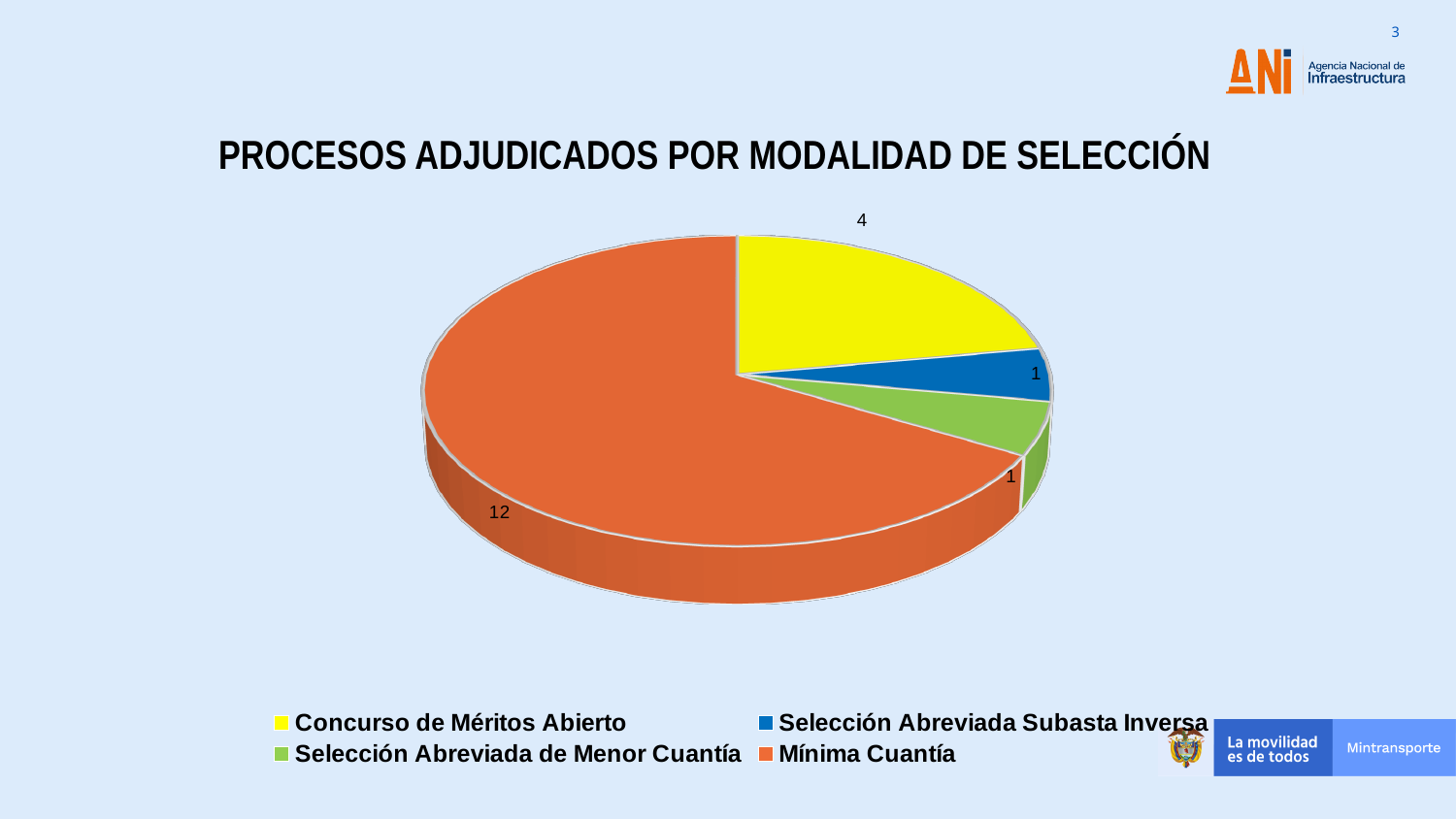
What is the value for Selección Abreviada Subasta Inversa? 1 What is the value for Mínima Cuantía? 12 Which category has the largest slice of the pie? Mínima Cuantía What is the value for Concurso de Méritos Abierto? 4 What is the value for Selección Abreviada de Menor Cuantía? 1 What is the title of the chart? PROCESOS ADJUDICADOS POR MODALIDAD DE SELECCIÓN What is the total of all the slices in the pie chart? 18 What is the difference between the values for Mínima Cuantía and Concurso de Méritos Abierto? 8 What kind of chart is shown on the slide? Pie chart What share of the total does the Mínima Cuantía slice represent? 12 of 18 (two thirds) How many categories does the pie chart have? 4 Which is larger, the value for Concurso de Méritos Abierto or the value for Selección Abreviada Subasta Inversa? Concurso de Méritos Abierto